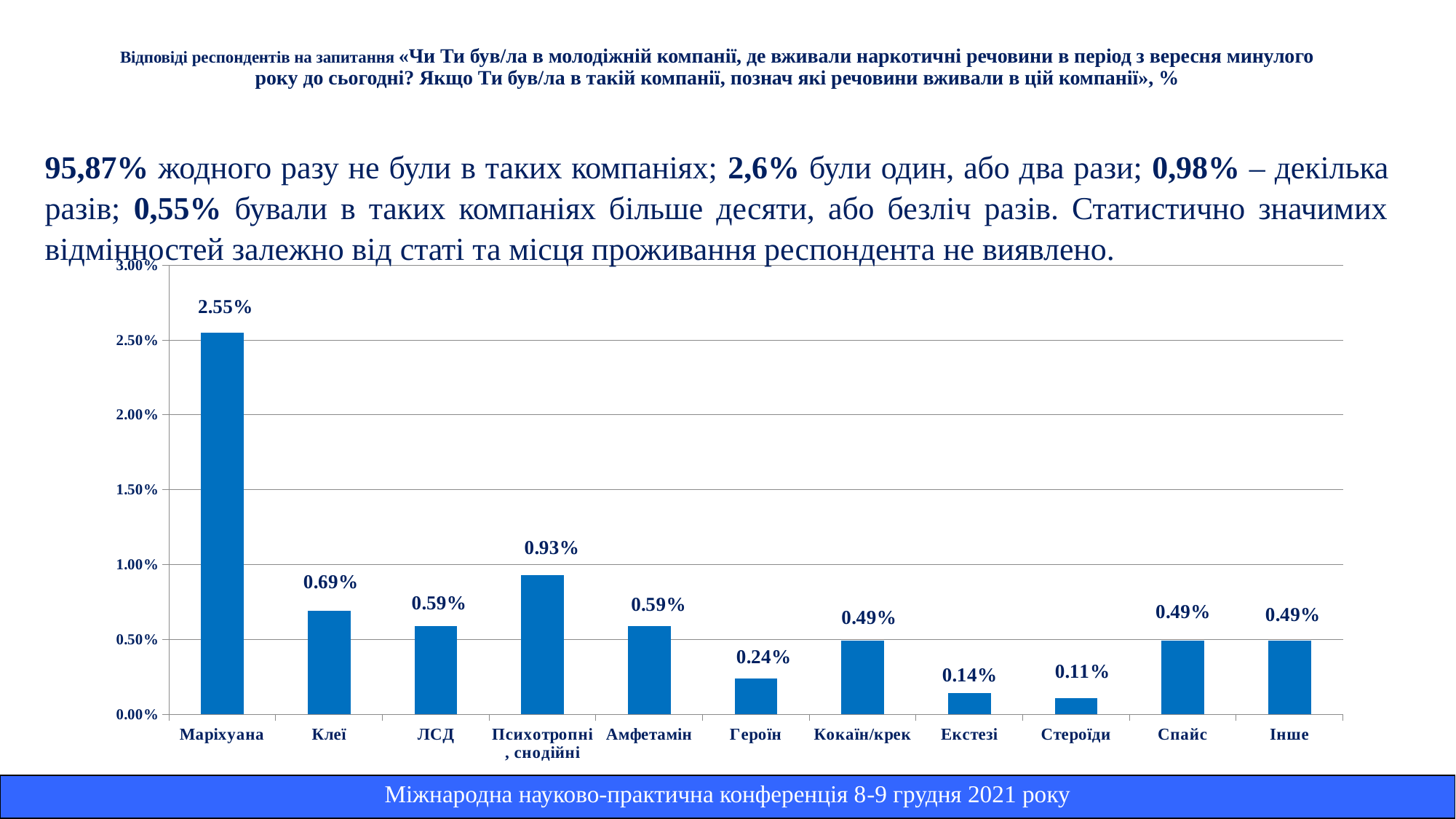
What is the difference between the values for Клеї and Екстезі? 0.55% What is the difference between the values for Маріхуана and Психотропні, снодійні? 1.62% What is the value for Стероїди? 0.11% What kind of chart is shown on the slide? bar chart Which is larger, the value for Клеї or the value for Кокаїн/крек? Клеї Which category has the lowest value? Стероїди How many categories are shown on the x axis? 11 Is the value for Амфетамін greater or less than 0.50%? greater What is the value for Маріхуана? 2.55% What is the value for Героїн? 0.24% Which category has the highest value? Маріхуана What is the value for Психотропні, снодійні? 0.93%